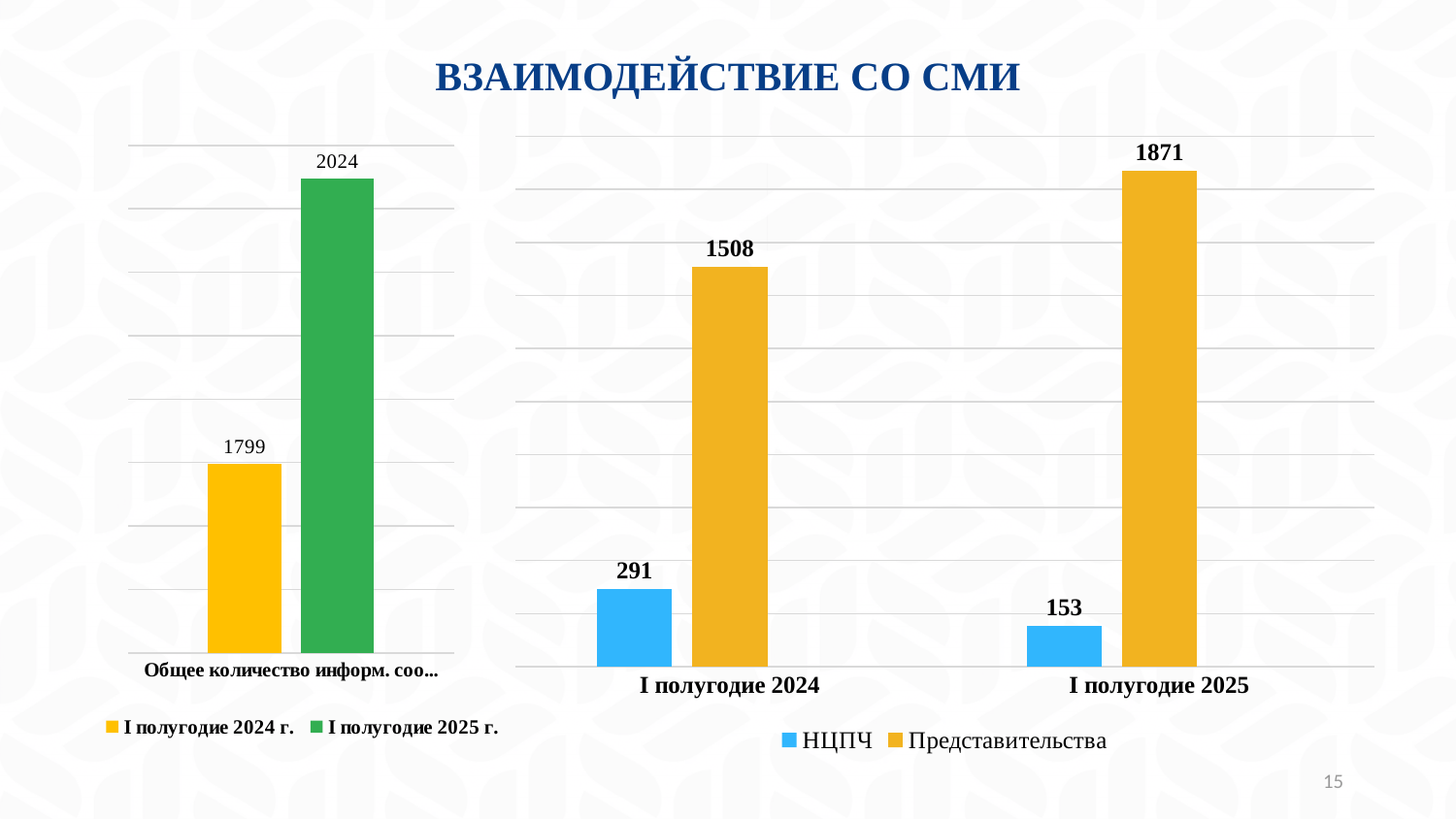
In the left chart, how many series does the legend list? 2 In the right chart, what is the value for Представительства in I полугодие 2025? 1871 In the left chart, what is the value for I полугодие 2024 г.? 1799 In the left chart, what is the value for I полугодие 2025 г.? 2024 In the right chart, what is the difference between the Представительства values for I полугодие 2025 and I полугодие 2024? 363 In the right chart, what is the value for НЦПЧ in I полугодие 2025? 153 What kind of chart is the right chart? Bar chart In the right chart, what is the value for НЦПЧ in I полугодие 2024? 291 In the right chart, which category has the highest value for Представительства? I полугодие 2025 In the right chart, how many categories are shown on the x axis? 2 In the right chart, which is larger: НЦПЧ in I полугодие 2024 or НЦПЧ in I полугодие 2025? НЦПЧ in I полугодие 2024 In the left chart, what is the difference between the I полугодие 2025 г. and I полугодие 2024 г. values? 225